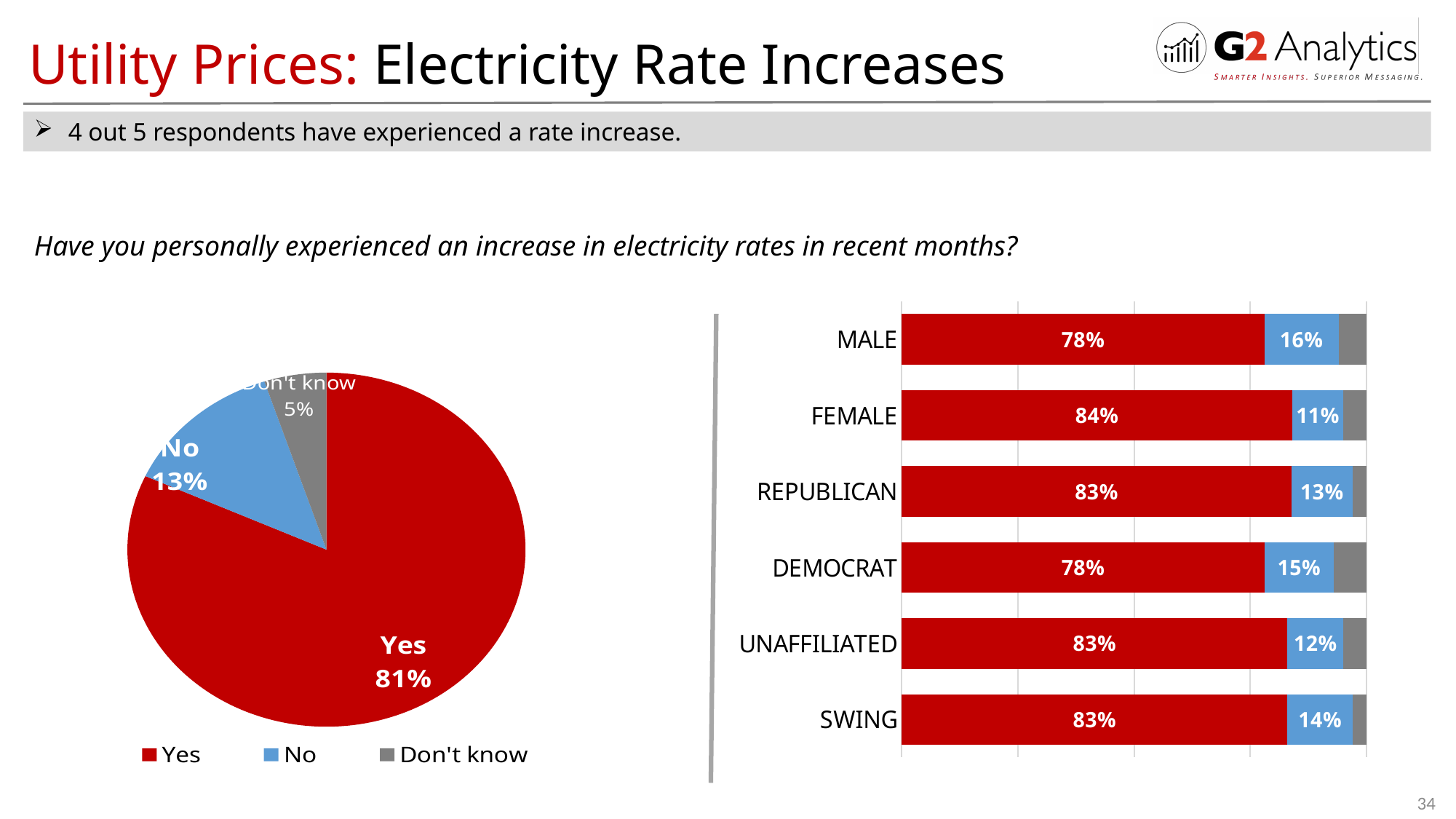
In the pie chart on the left, what share of respondents answered No? 13% In the bar chart on the right, which group has the highest Yes percentage? FEMALE In the bar chart on the right, what is the difference between the Yes percentages for FEMALE and MALE respondents? 6% In the bar chart on the right, what percentage of MALE respondents answered No? 16% In the pie chart on the left, what share of respondents answered Yes? 81% In the bar chart on the right, what percentage of FEMALE respondents answered Yes? 84% In the pie chart on the left, how many entries does the legend list? 3 What type of chart is shown on the right side of the slide? Stacked bar chart In the pie chart on the left, which response has the smallest slice? Don't know In the bar chart on the right, which group has the lowest No percentage? FEMALE In the pie chart on the left, what share of respondents answered Don't know? 5% In the bar chart on the right, how many groups are shown? 6